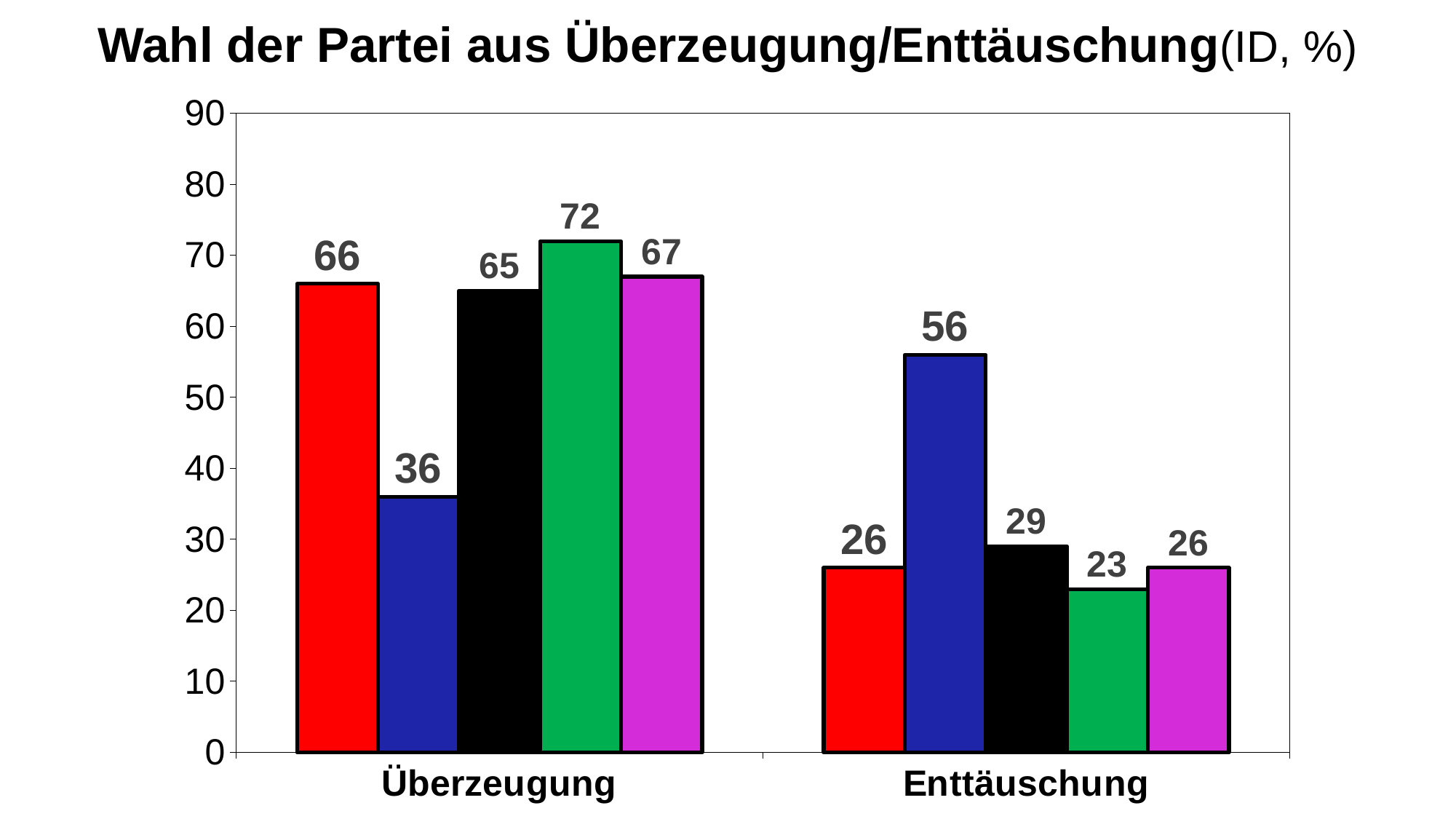
Is the value of the blue bar for Überzeugung greater or less than 40? less How many bars are shown in each category group? 5 What is the title of the chart? Wahl der Partei aus Überzeugung/Enttäuschung (ID, %) Which bar is the lowest in the Enttäuschung group? the green bar (23) How many categories are shown on the x axis? 2 What is the value of the red bar for Überzeugung? 66 What is the value of the green bar for Überzeugung? 72 Which bar is the highest in the Überzeugung group? the green bar (72) What is the value of the blue bar for Enttäuschung? 56 What is the difference between the blue bar for Enttäuschung and the blue bar for Überzeugung? 20 Which is larger: the black bar for Überzeugung or the magenta bar for Überzeugung? the magenta bar (67) What kind of chart is shown on the slide? bar chart